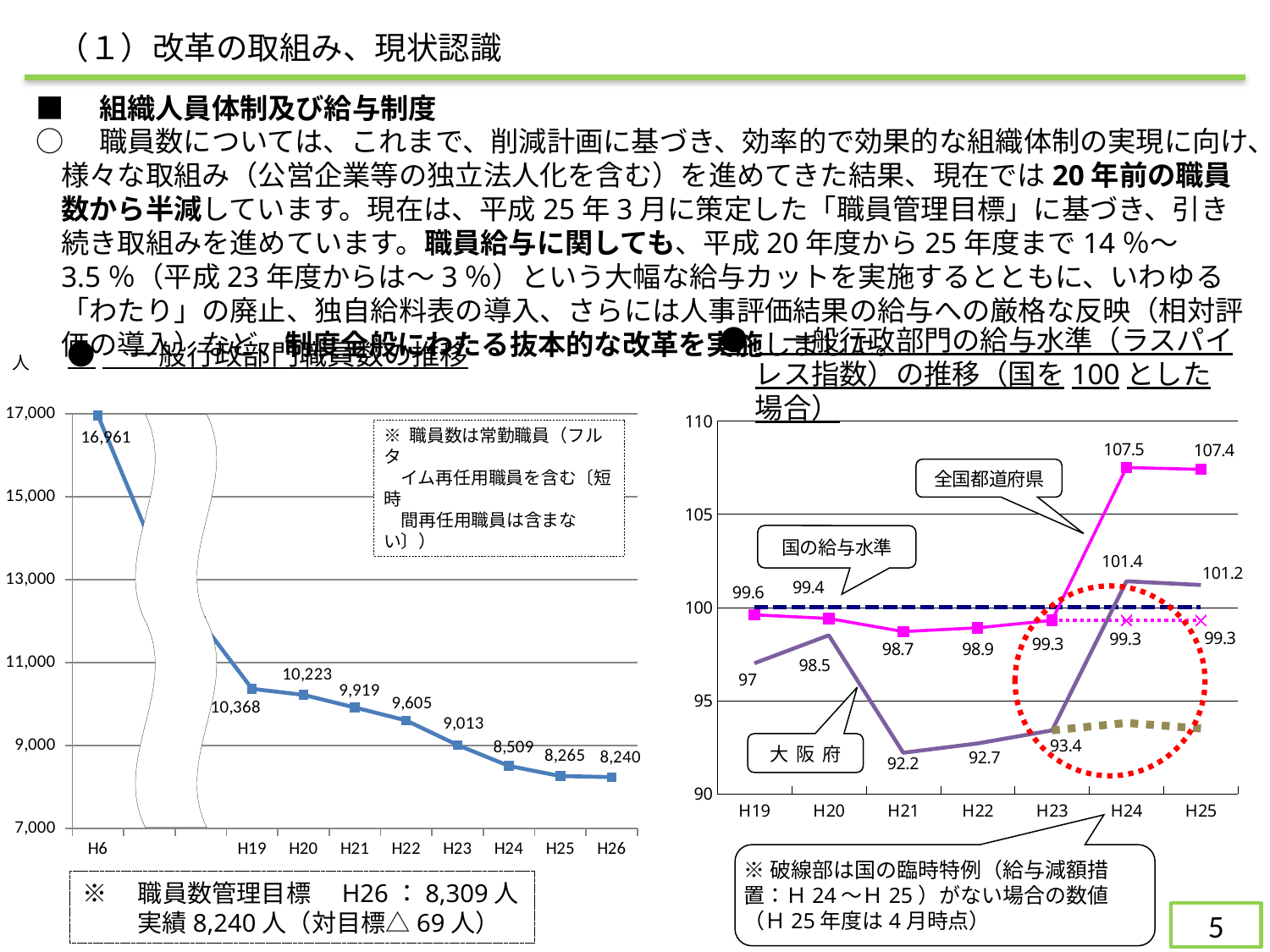
On the left chart, what is the value for H6? 16,961 On the left chart, do the values rise or fall from H19 to H26? fall On the left chart, what is the value for H23? 9,013 On the right chart, which is larger in H23: 全国都道府県 or 大阪府? 全国都道府県 On the left chart, what is the difference between the H19 value and the H20 value? 145 On the left chart, which year has the lowest value? H26 On the right chart, what is the value for 大阪府 in H21? 92.2 On the right chart, what is the difference between the 全国都道府県 value and the 大阪府 value in H25? 6.2 What kind of chart is the left chart? line chart On the left chart, what is the value for H26? 8,240 On the left chart, how many years are shown on the x axis? 9 On the right chart, what is the value for 全国都道府県 in H24? 107.5